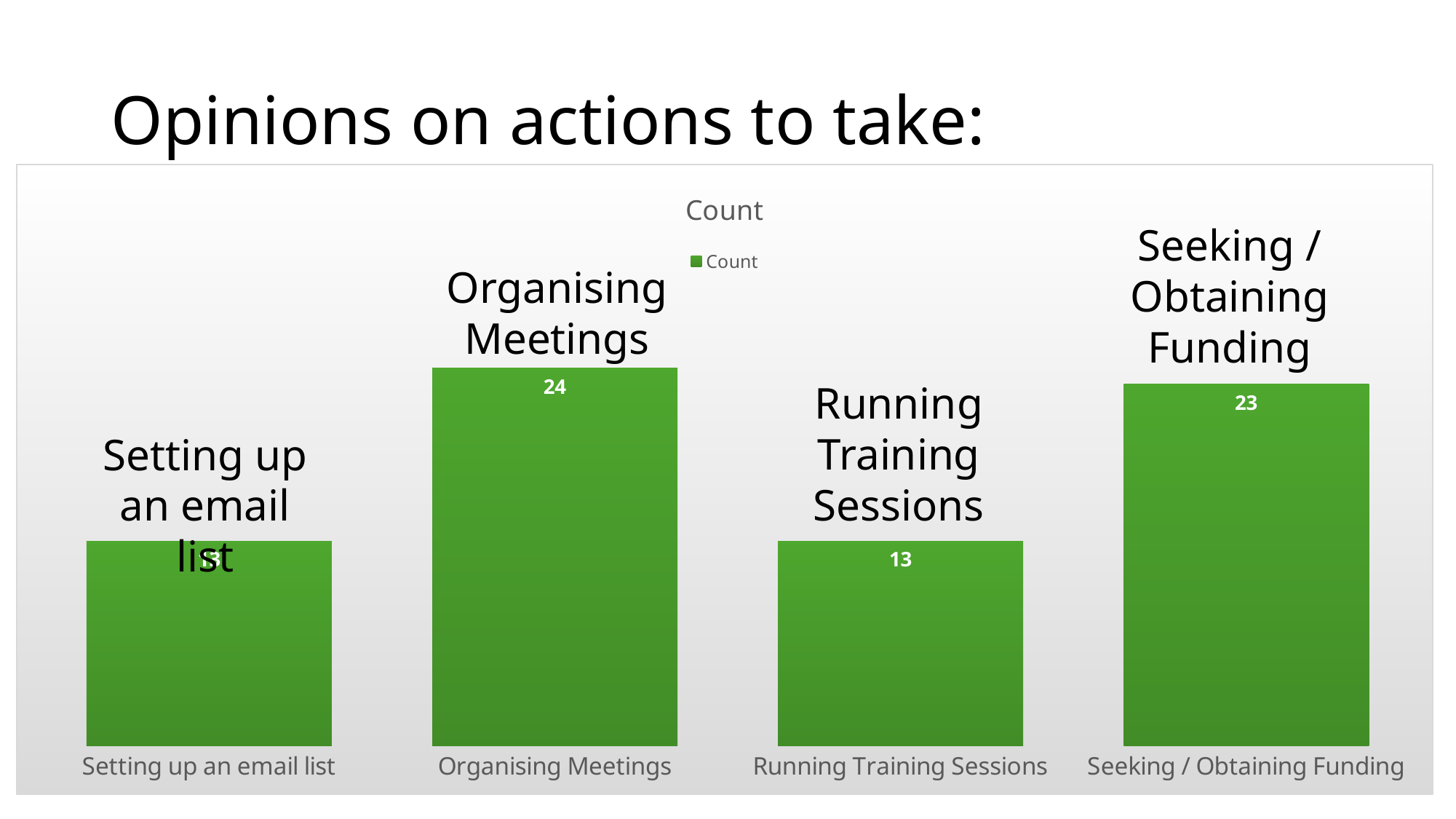
Which is larger, the value for Organising Meetings or the value for Seeking / Obtaining Funding? Organising Meetings What is the value for Organising Meetings? 24 What is the value for Seeking / Obtaining Funding? 23 What is the difference between the values for Organising Meetings and Running Training Sessions? 11 Which category has the highest value? Organising Meetings How many series does the legend list? 1 What is the difference between the values for Organising Meetings and Seeking / Obtaining Funding? 1 How many categories are shown in the chart? 4 Which is larger, the value for Running Training Sessions or the value for Seeking / Obtaining Funding? Seeking / Obtaining Funding What is the value for Running Training Sessions? 13 What kind of chart is shown on the slide? Bar chart What is the difference between the values for Seeking / Obtaining Funding and Running Training Sessions? 10